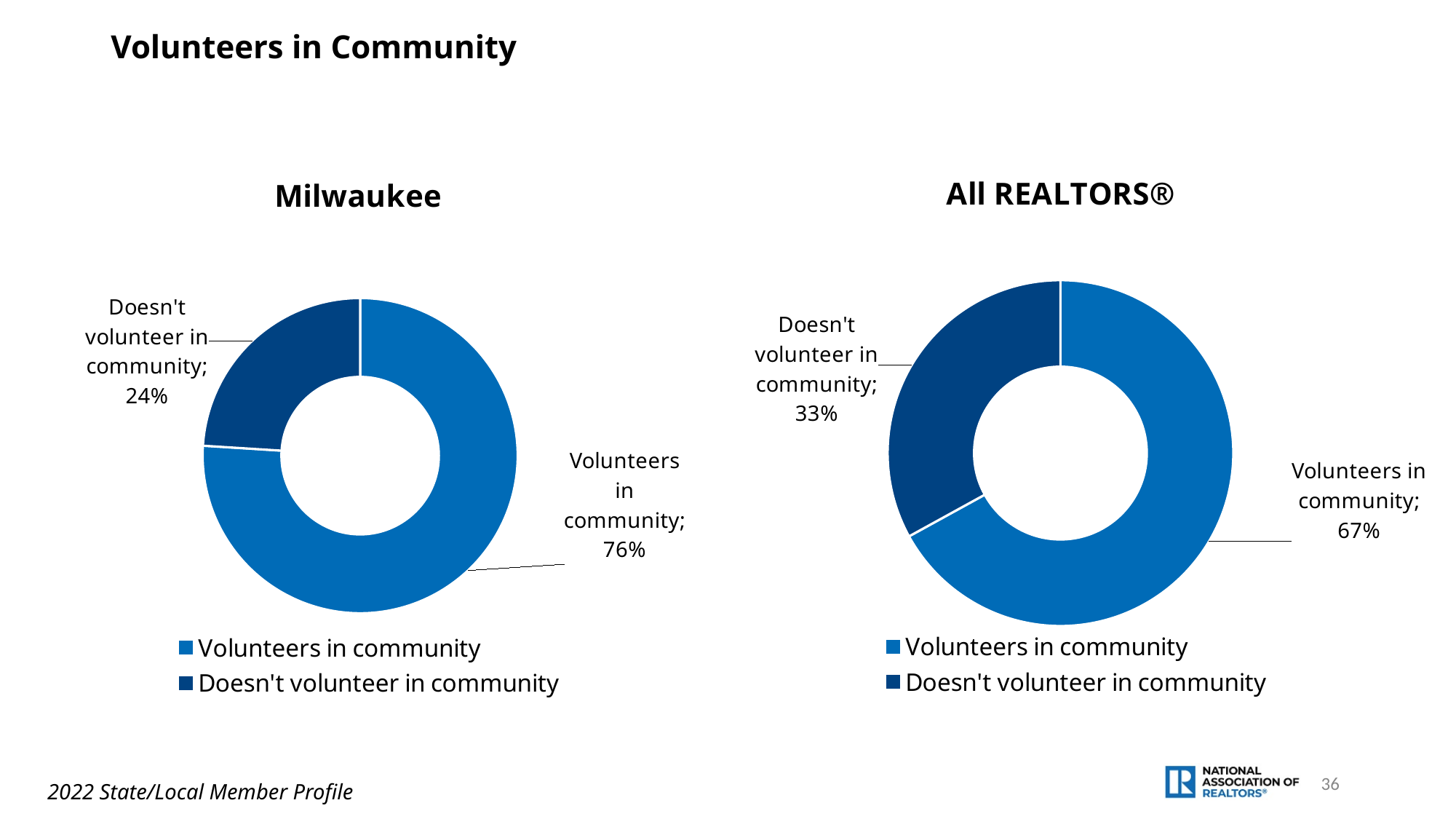
How many entries does the legend of the All REALTORS® chart list? 2 What type of chart is used for the All REALTORS® data? Doughnut chart What is the title of the slide? Volunteers in Community In the All REALTORS® chart, what percentage of members don't volunteer in the community? 33% How many categories does the Milwaukee chart show? 2 In the Milwaukee chart, what is the difference in percentage points between those who volunteer and those who don't? 52 In the Milwaukee chart, what percentage of members don't volunteer in the community? 24% In the Milwaukee chart, what percentage of members volunteer in the community? 76% In the All REALTORS® chart, which category has the smallest share? Doesn't volunteer in community Which chart shows a higher share of members who volunteer in the community, Milwaukee or All REALTORS®? Milwaukee In the Milwaukee chart, which category has the largest share? Volunteers in community In the All REALTORS® chart, what percentage of members volunteer in the community? 67%